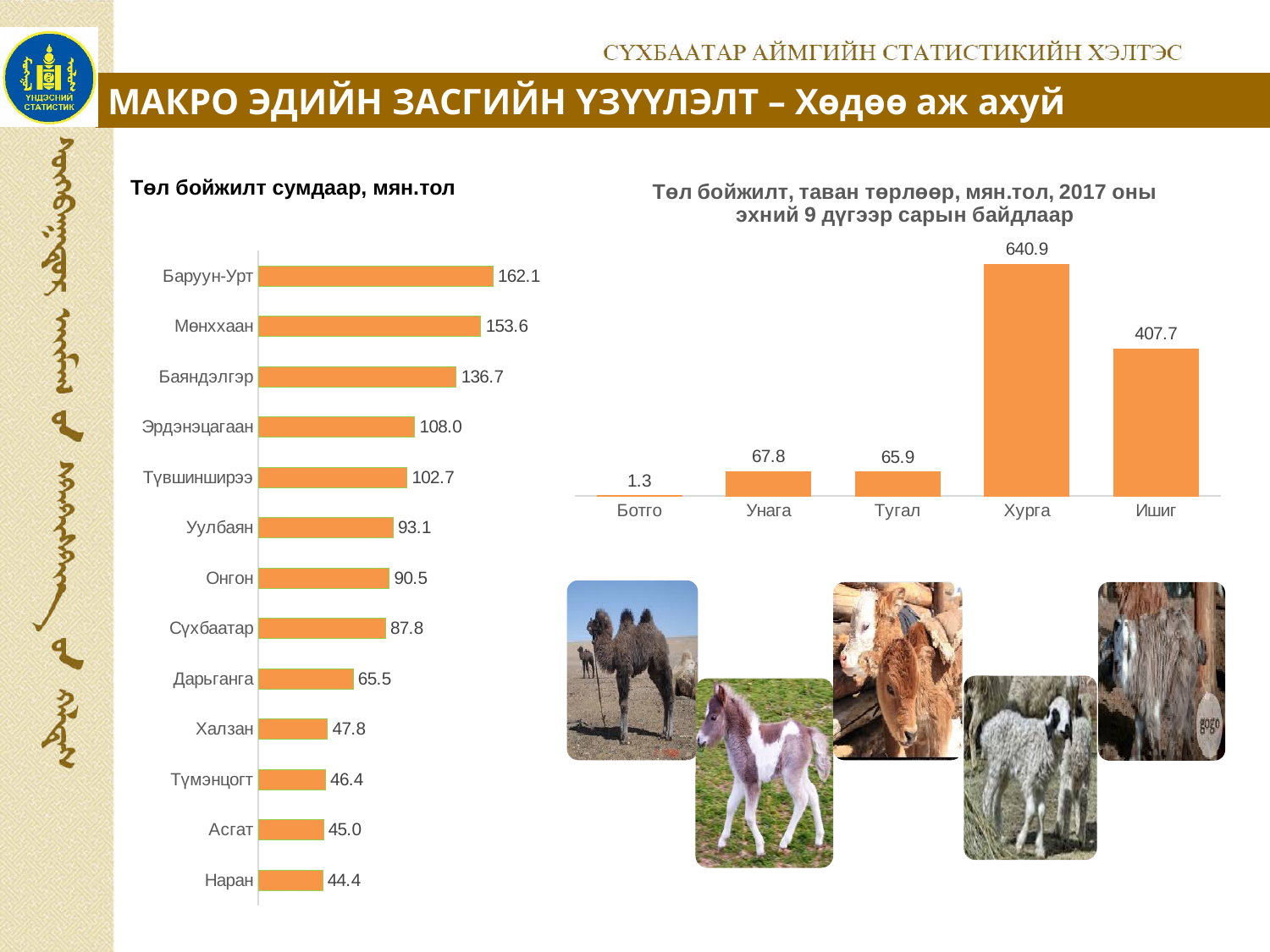
In the chart 'Төл бойжилт сумдаар, мян.тол', what is the difference between the values for Мөнххаан and Баяндэлгэр? 16.9 In the chart 'Төл бойжилт, таван төрлөөр, мян.тол, 2017 оны эхний 9 дүгээр сарын байдлаар', how many categories are shown? 5 In the chart 'Төл бойжилт сумдаар, мян.тол', what is the value for Баруун-Урт? 162.1 What kind of chart is the chart 'Төл бойжилт сумдаар, мян.тол'? Bar chart In the chart 'Төл бойжилт, таван төрлөөр, мян.тол, 2017 оны эхний 9 дүгээр сарын байдлаар', which category has the lowest value? Ботго In the chart 'Төл бойжилт сумдаар, мян.тол', which category has the highest value? Баруун-Урт In the chart 'Төл бойжилт, таван төрлөөр, мян.тол, 2017 оны эхний 9 дүгээр сарын байдлаар', what is the value for Хурга? 640.9 In the chart 'Төл бойжилт сумдаар, мян.тол', which category has the lowest value? Наран In the chart 'Төл бойжилт сумдаар, мян.тол', which is larger, the value for Уулбаян or the value for Онгон? Уулбаян In the chart 'Төл бойжилт, таван төрлөөр, мян.тол, 2017 оны эхний 9 дүгээр сарын байдлаар', what is the difference between the values for Хурга and Ишиг? 233.2 In the chart 'Төл бойжилт сумдаар, мян.тол', how many categories are shown? 13 In the chart 'Төл бойжилт сумдаар, мян.тол', what is the value for Дарьганга? 65.5